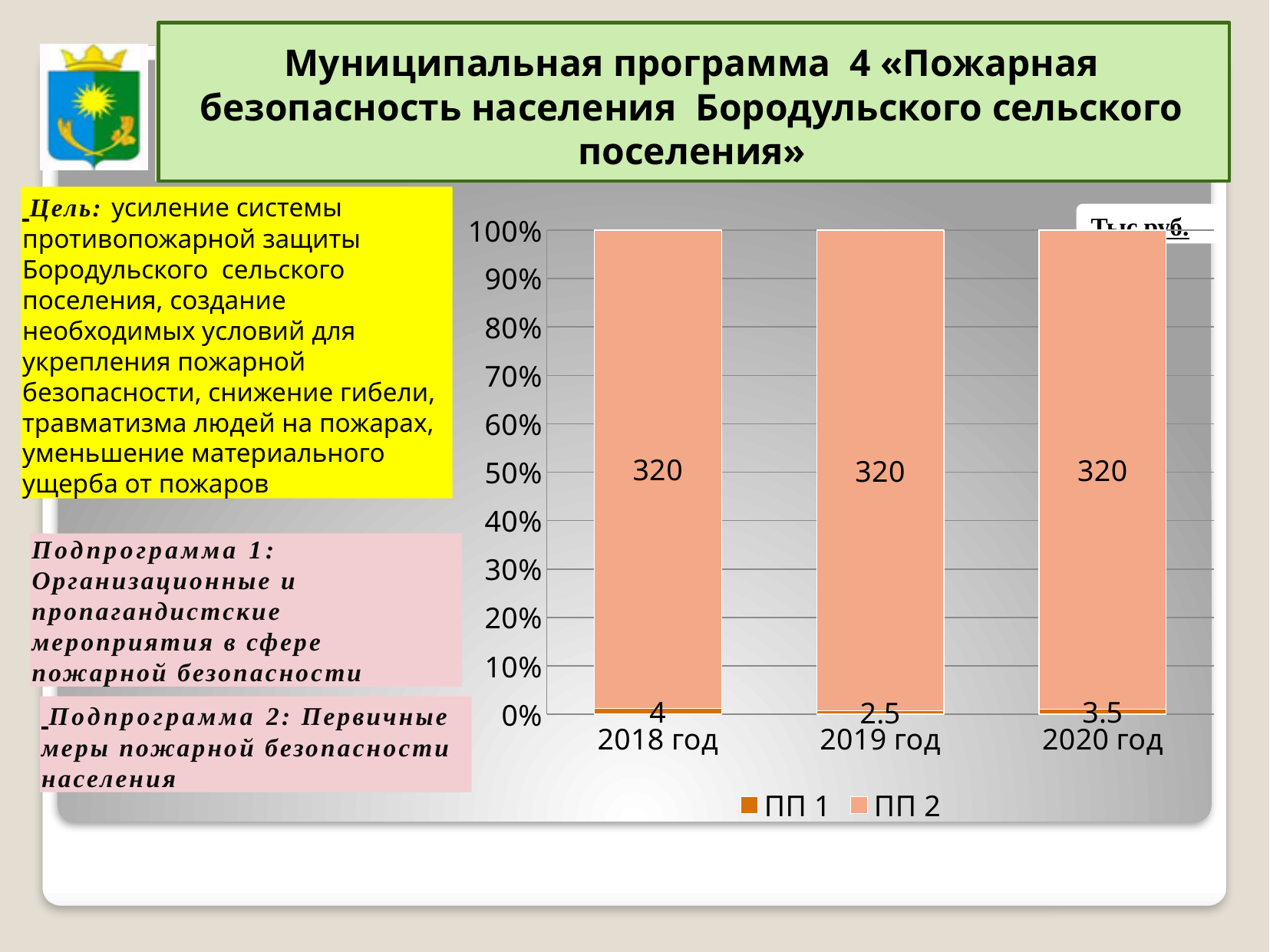
Which year has the lowest value for ПП 1? 2019 год Which is larger, the ПП 1 value for 2020 год or for 2019 год? 2020 год What is the value of ПП 2 for 2018 год? 320 What is the difference between the ПП 1 values for 2018 год and 2019 год? 1.5 What type of chart is shown on the slide? Stacked bar chart How many years are shown on the x axis of the chart? 3 What is the value of ПП 1 for 2020 год? 3.5 What is the value of ПП 1 for 2018 год? 4 Which year has the highest value for ПП 1? 2018 год How many series does the chart legend list? 2 What is the total of ПП 1 and ПП 2 for 2020 год? 323.5 What is the value of ПП 1 for 2019 год? 2.5